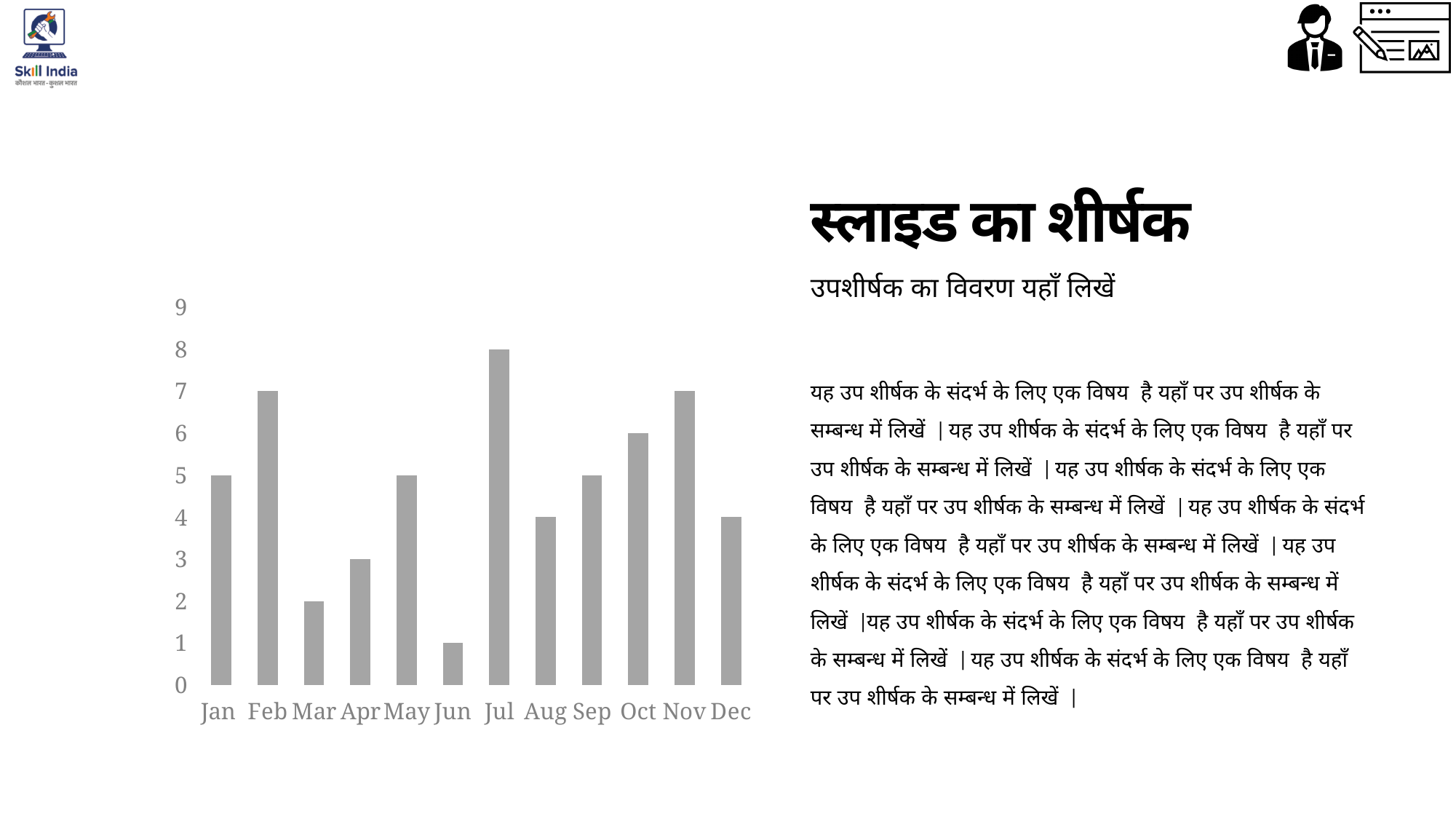
Which month has the highest bar in the chart? Jul What is the value for Oct in the chart? 6 Is the value for Nov greater or less than 5? greater Which month has the lowest bar in the chart? Jun What is the value for Jun in the chart? 1 Which is larger in the chart, the value for Mar or the value for Apr? Apr What kind of chart is shown on the slide? bar chart What is the value for Jul in the chart? 8 What is the difference between the values for Jul and Jun in the chart? 7 How many months are shown on the x axis of the chart? 12 What is the value for Feb in the chart? 7 Is the value for Mar greater or less than 4? less